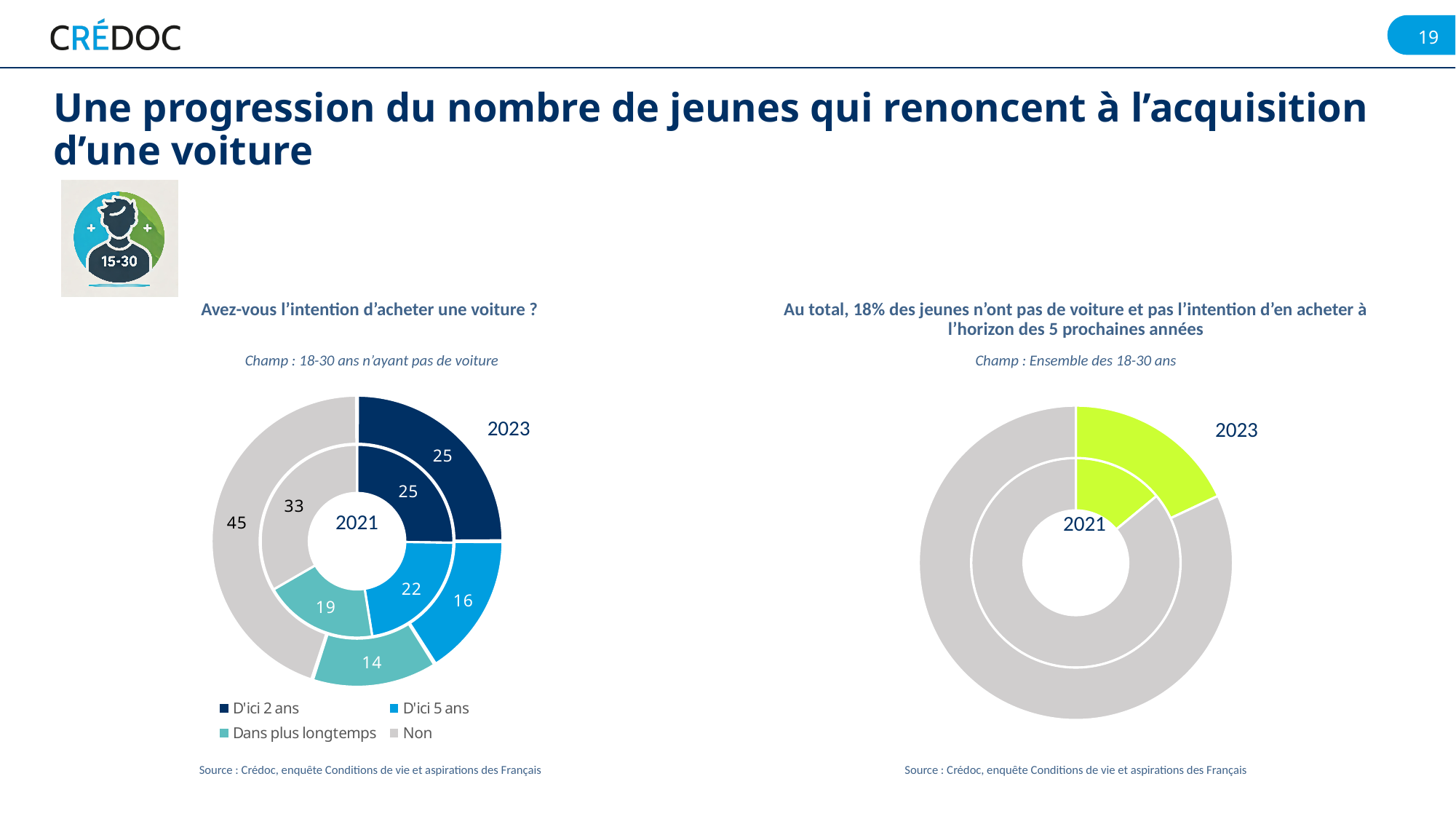
In the left chart 'Avez-vous l'intention d'acheter une voiture ?', what is the value for 'D'ici 5 ans' in 2023? 16 In the left chart 'Avez-vous l'intention d'acheter une voiture ?', what is the value for 'Non' in 2023? 45 In the left chart 'Avez-vous l'intention d'acheter une voiture ?', which category has the lowest value in 2023? Dans plus longtemps In the left chart 'Avez-vous l'intention d'acheter une voiture ?', what is the value for 'Non' in 2021? 33 In the left chart 'Avez-vous l'intention d'acheter une voiture ?', which category has the highest value in 2023? Non In the left chart 'Avez-vous l'intention d'acheter une voiture ?', what is the difference between 'D'ici 2 ans' and 'Dans plus longtemps' in 2023? 11 How many categories does the legend of the left chart 'Avez-vous l'intention d'acheter une voiture ?' list? 4 In the left chart 'Avez-vous l'intention d'acheter une voiture ?', is the value for 'D'ici 5 ans' larger in 2021 or in 2023? 2021 In the left chart 'Avez-vous l'intention d'acheter une voiture ?', by how much did the value for 'Non' increase from 2021 to 2023? 12 What kind of chart is the right chart 'Au total, 18% des jeunes n'ont pas de voiture...'? Doughnut chart Which two years are shown as rings in the right chart 'Au total, 18% des jeunes n'ont pas de voiture...'? 2021 and 2023 In the left chart 'Avez-vous l'intention d'acheter une voiture ?', what is the value for 'Dans plus longtemps' in 2021? 19